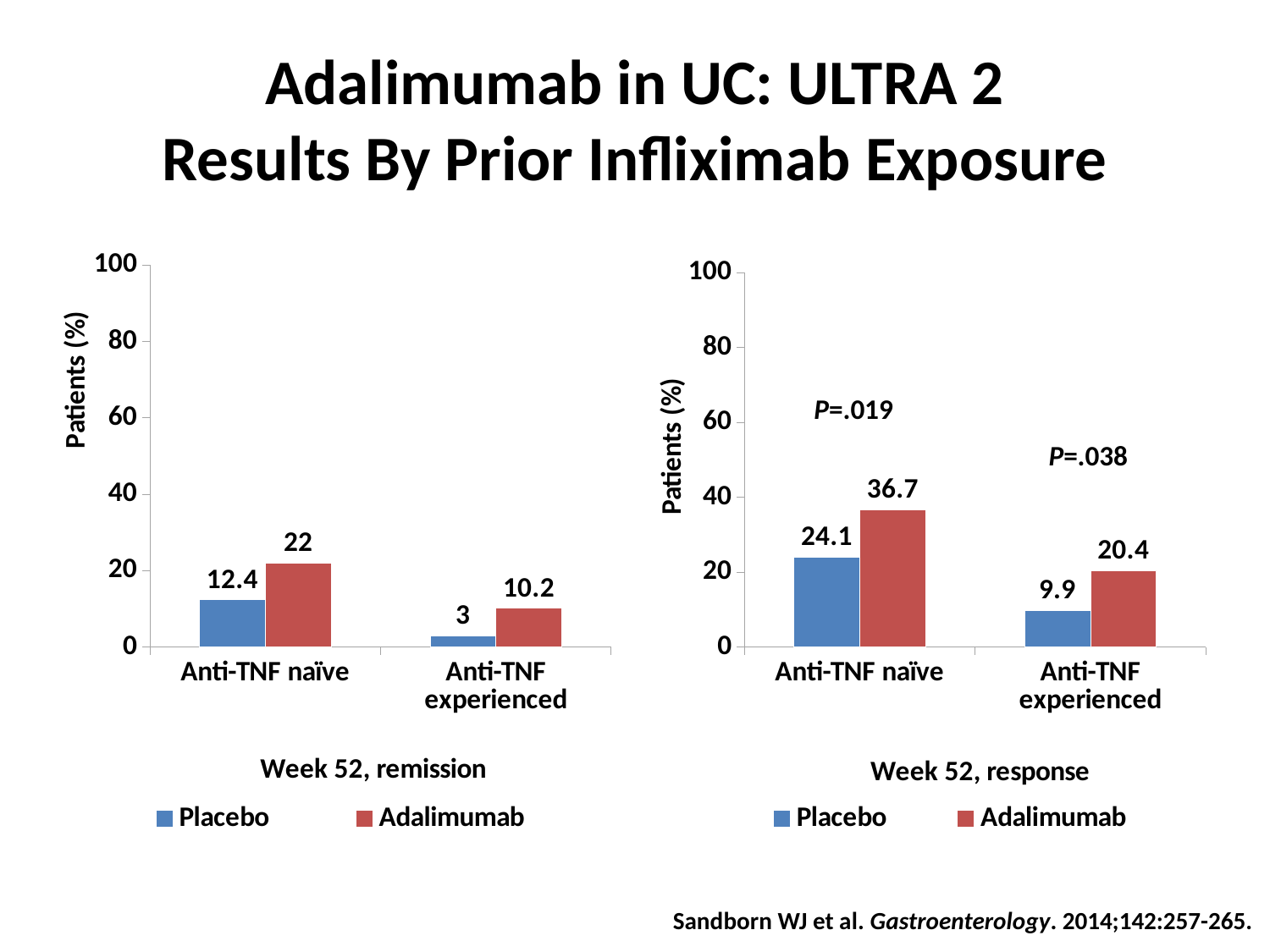
In the 'Week 52, response' chart, what is the difference between Adalimumab and Placebo in the Anti-TNF experienced group? 10.5 In the 'Week 52, response' chart, is the Placebo value for the Anti-TNF naïve group larger or smaller than the Adalimumab value for the Anti-TNF experienced group? larger In the 'Week 52, remission' chart, is the Adalimumab value for the Anti-TNF naïve group greater or less than 20? greater In the 'Week 52, response' chart, which bar has the highest value? Adalimumab, Anti-TNF naïve In the 'Week 52, remission' chart, what is the value for Placebo in the Anti-TNF experienced group? 3 In the 'Week 52, remission' chart, what is the difference between Adalimumab and Placebo in the Anti-TNF naïve group? 9.6 How many series does the legend of the 'Week 52, response' chart list? 2 In the 'Week 52, remission' chart, what is the value for Adalimumab in the Anti-TNF naïve group? 22 What type of chart is the 'Week 52, remission' chart? Bar chart In the 'Week 52, remission' chart, which bar has the lowest value? Placebo, Anti-TNF experienced In the 'Week 52, response' chart, what is the value for Placebo in the Anti-TNF experienced group? 9.9 In the 'Week 52, response' chart, what is the value for Adalimumab in the Anti-TNF naïve group? 36.7